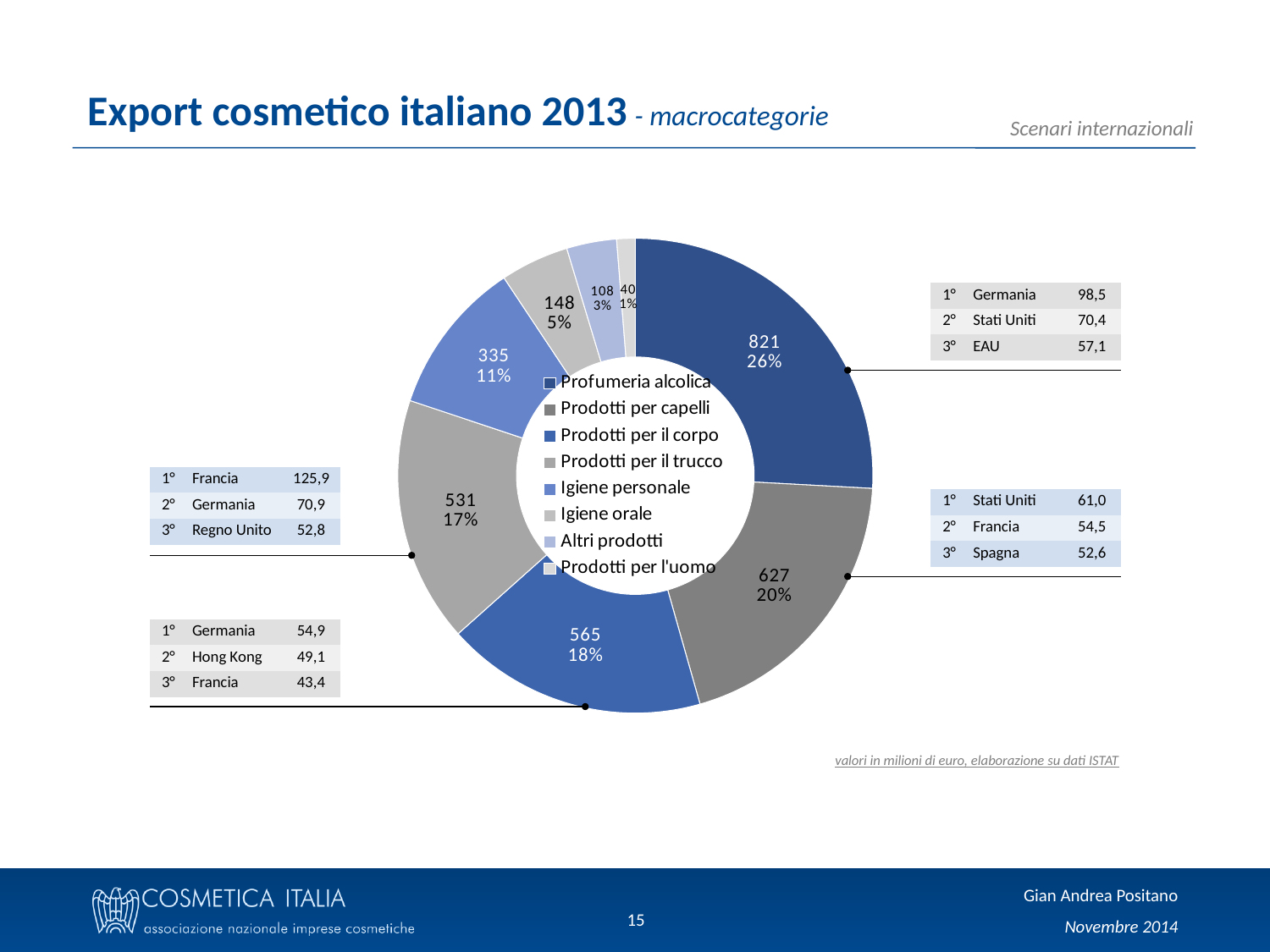
What is the value shown for Prodotti per capelli? 627 What kind of chart is shown on the slide? doughnut (pie) chart What is the title of the slide containing the chart? Export cosmetico italiano 2013 - macrocategorie Which is larger, the value for Prodotti per il trucco or the value for Igiene personale? Prodotti per il trucco What share of the total does Igiene orale represent? 5% Which category has the largest value in the chart? Profumeria alcolica How many categories does the chart show? 8 Which category has the smallest value in the chart? Prodotti per l'uomo What share of the total does Prodotti per il corpo represent? 18% What is the value shown for Igiene personale? 335 What is the value shown for Profumeria alcolica? 821 What is the difference between the values for Profumeria alcolica and Prodotti per capelli? 194